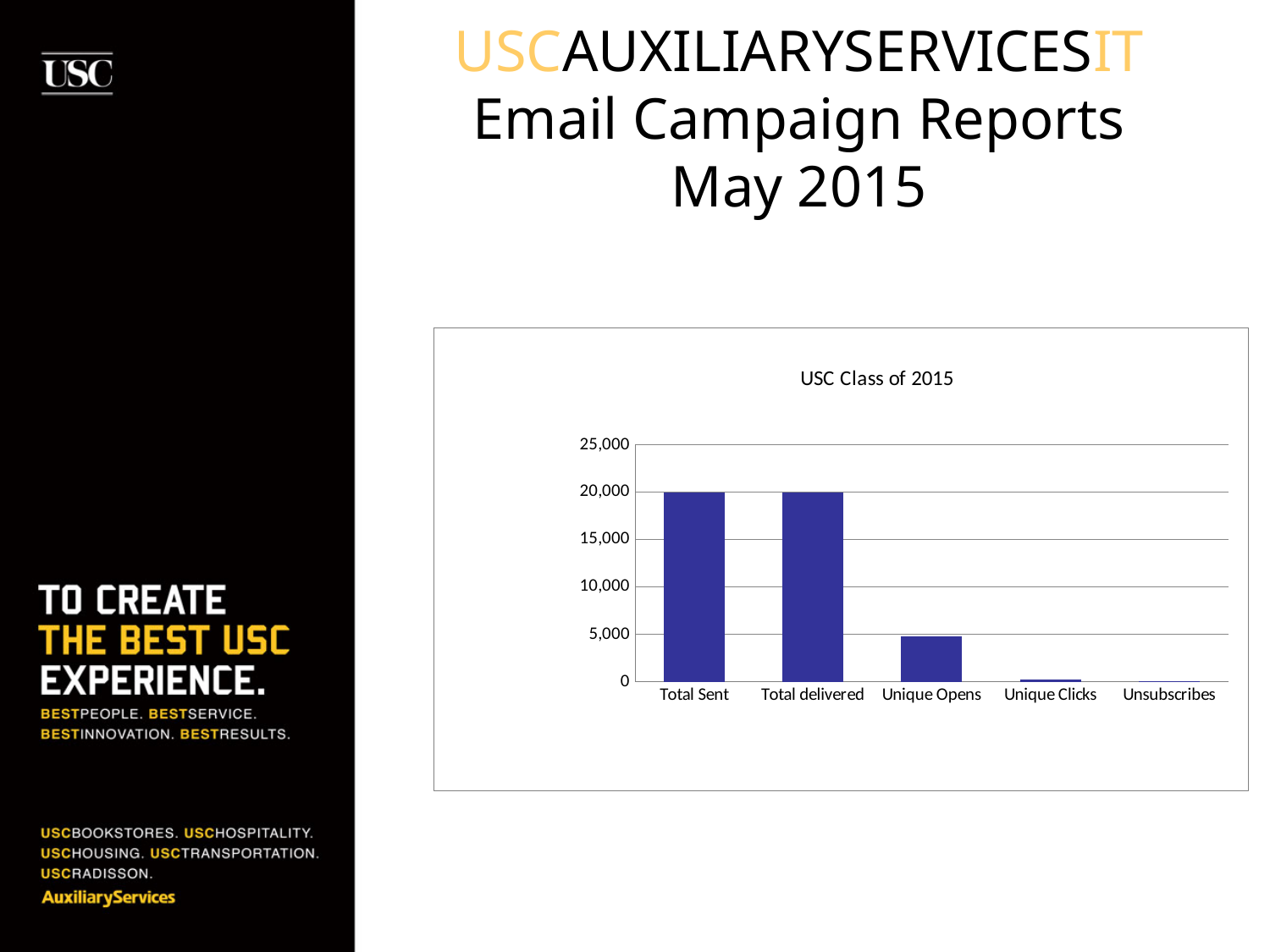
What colour are the bars in the chart? blue Is the value for Total Sent greater or less than 15,000? greater Is the value for Total delivered greater or less than 15,000? greater Do the values generally rise or fall moving from left to right along the x axis? fall What is the title of the chart? USC Class of 2015 Is the value for Unique Clicks greater or less than 5,000? less Which is larger, the value for Total Sent or the value for Unique Opens? Total Sent How many categories are plotted on the x axis of the chart? 5 Which is larger, the value for Unique Opens or the value for Unique Clicks? Unique Opens Which category has the lowest value in the chart? Unsubscribes What kind of chart is shown on the slide? bar chart